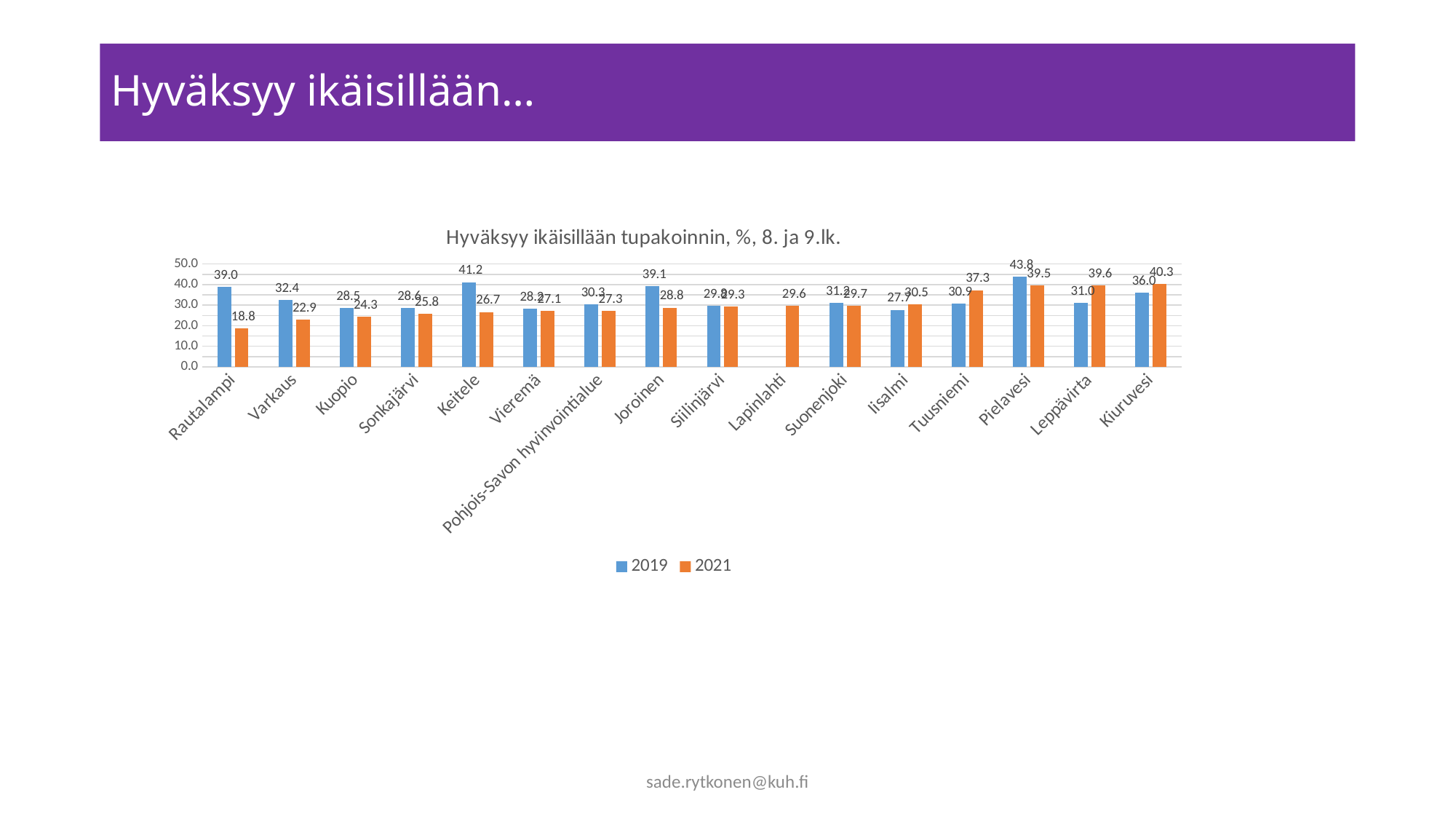
Which category has the lowest 2021 value? Rautalampi What is the 2019 value for Keitele? 41.2 What is the difference between the 2019 and 2021 values for Rautalampi? 20.2 What is the 2021 value for Rautalampi? 18.8 Which category has the highest 2021 value? Kiuruvesi What kind of chart is shown on the slide? Bar chart What is the 2021 value for Tuusniemi? 37.3 How many categories are shown on the x axis? 16 Which category has the highest 2019 value? Pielavesi Is the 2019 value for Pielavesi greater or less than 40.0? greater How many series does the legend list? 2 Which is larger for Leppävirta, the 2019 value or the 2021 value? 2021